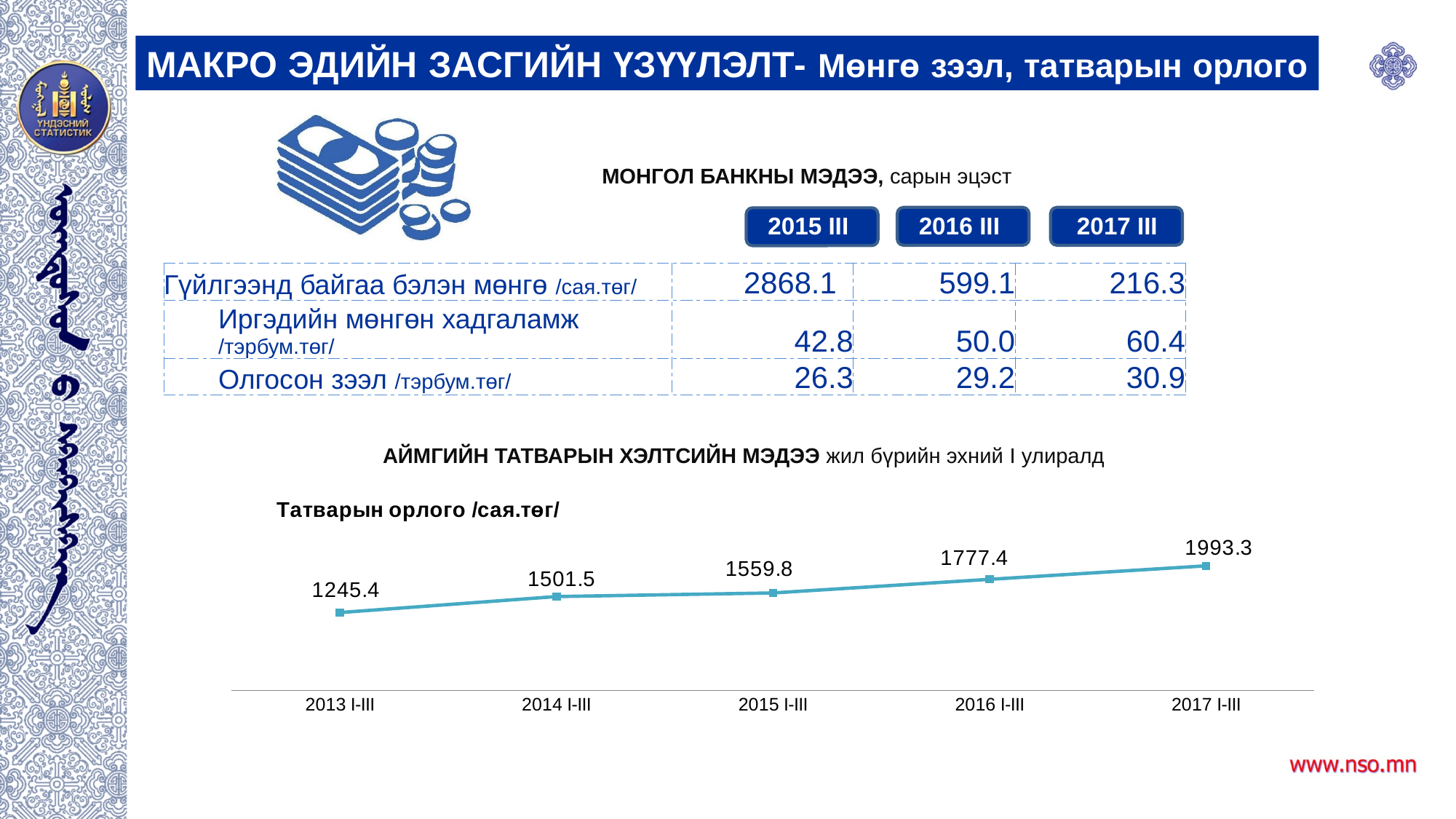
What is the title of the line chart on the slide? Татварын орлого /сая.төг/ Which period has the lowest value in the "Татварын орлого /сая.төг/" chart? 2013 I-III What type of chart is shown under "Татварын орлого /сая.төг/"? line chart What is the value for 2013 I-III in the "Татварын орлого /сая.төг/" chart? 1245.4 In the "Татварын орлого /сая.төг/" chart, which is larger: the value for 2015 I-III or 2016 I-III? 2016 I-III Do the values in the "Татварын орлого /сая.төг/" chart rise or fall from 2013 I-III to 2017 I-III? rise In the "Татварын орлого /сая.төг/" chart, what is the difference between the 2017 I-III and 2016 I-III values? 215.9 How many data points are plotted in the "Татварын орлого /сая.төг/" chart? 5 In the "Татварын орлого /сая.төг/" chart, what is the difference between the 2014 I-III and 2013 I-III values? 256.1 What is the value for 2017 I-III in the "Татварын орлого /сая.төг/" chart? 1993.3 Which period has the highest value in the "Татварын орлого /сая.төг/" chart? 2017 I-III What is the value for 2015 I-III in the "Татварын орлого /сая.төг/" chart? 1559.8